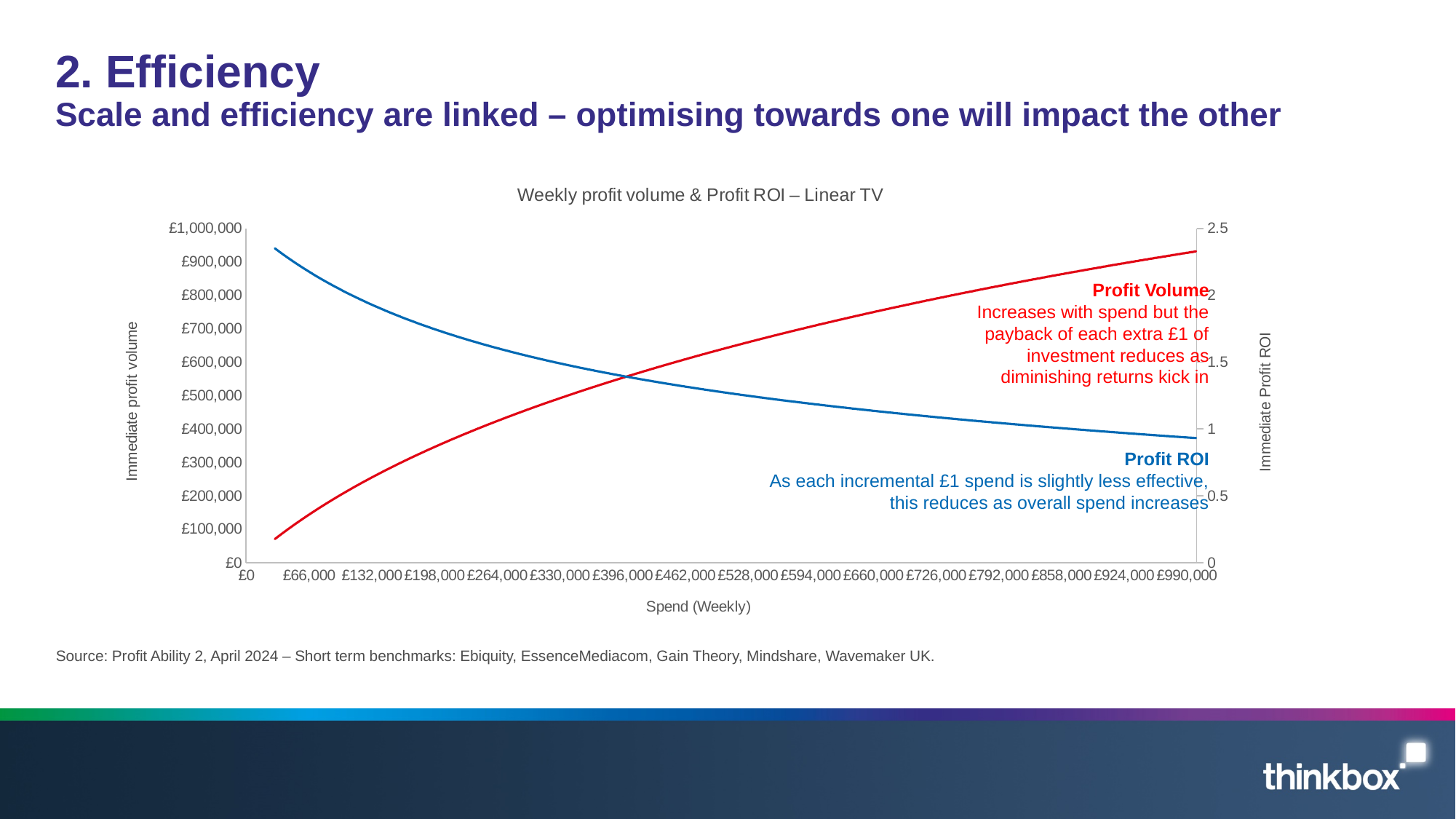
Is the Profit Volume value at £66,000 weekly spend greater or less than £200,000? less How many series are plotted on the chart? 2 Does the Profit ROI line rise or fall as weekly spend increases? Falls What is the title of the chart? Weekly profit volume & Profit ROI – Linear TV Is the Profit ROI value at £528,000 weekly spend greater or less than 1.5? less Is the Profit ROI value at the left-hand start of the chart greater or less than 2? greater What is the label of the horizontal axis of the chart? Spend (Weekly) Does the Profit Volume line rise or fall as weekly spend increases? Rises What kind of chart is shown on the slide? Line chart